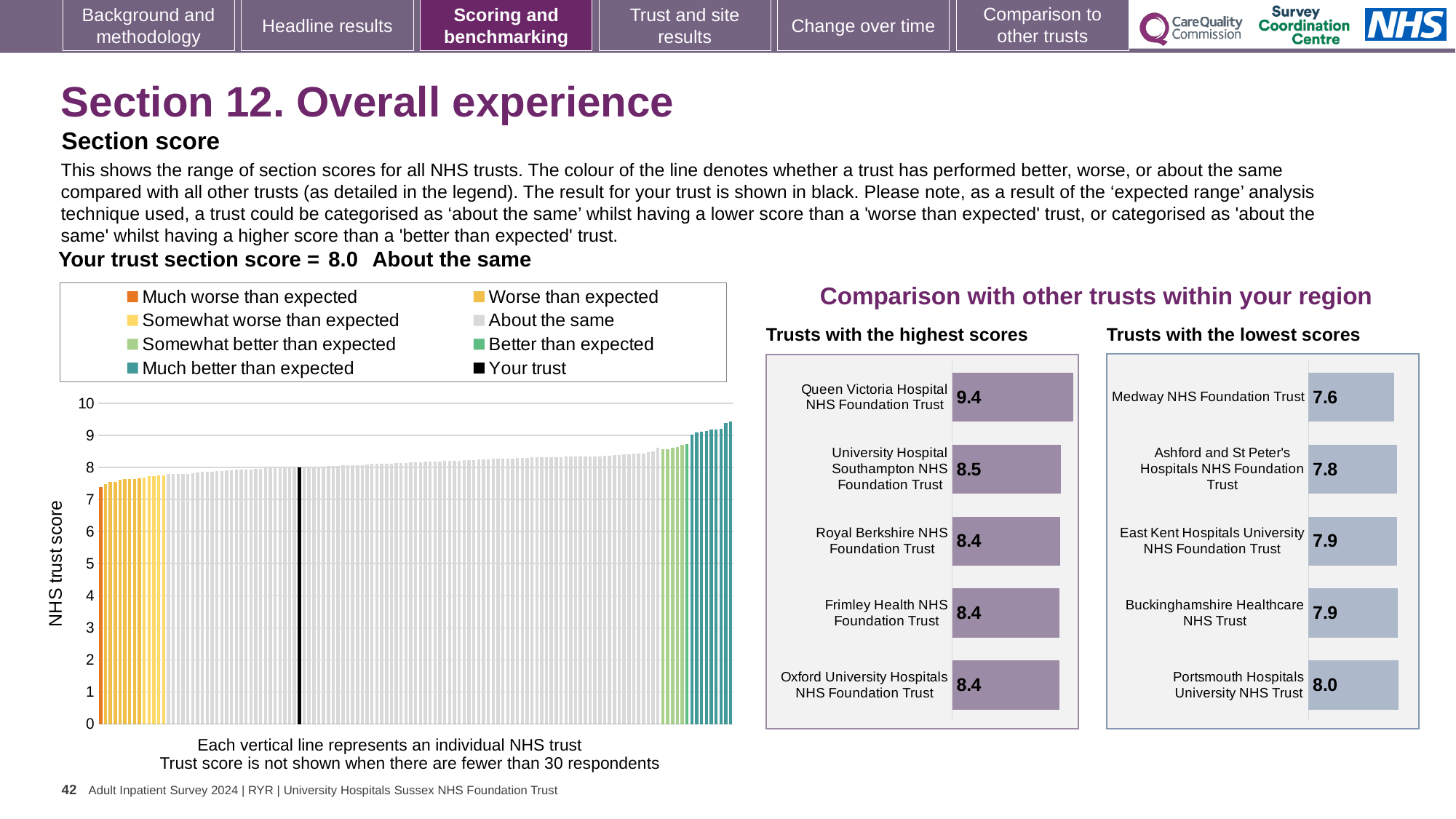
How many entries does the legend of the large chart on the left list? 8 In the 'Trusts with the lowest scores' chart, which trust has the lowest score? Medway NHS Foundation Trust In the 'Trusts with the lowest scores' chart, which trust has the highest score? Portsmouth Hospitals University NHS Trust How many trusts are shown in the 'Trusts with the highest scores' chart? 5 In the large chart on the left, do the values rise or fall from left to right along the x axis? rise In the 'Trusts with the highest scores' chart, what is the score for University Hospital Southampton NHS Foundation Trust? 8.5 In the 'Trusts with the lowest scores' chart, what is the score for Medway NHS Foundation Trust? 7.6 In the large chart on the left, is the value of the tallest bar greater or less than 9? greater In the 'Trusts with the highest scores' chart, what is the score for Queen Victoria Hospital NHS Foundation Trust? 9.4 In the 'Trusts with the highest scores' chart, what is the difference between the scores of Queen Victoria Hospital NHS Foundation Trust and University Hospital Southampton NHS Foundation Trust? 0.9 In the 'Trusts with the lowest scores' chart, which has the larger score: Medway NHS Foundation Trust or Portsmouth Hospitals University NHS Trust? Portsmouth Hospitals University NHS Trust What kind of chart is the 'Trusts with the lowest scores' chart? bar chart